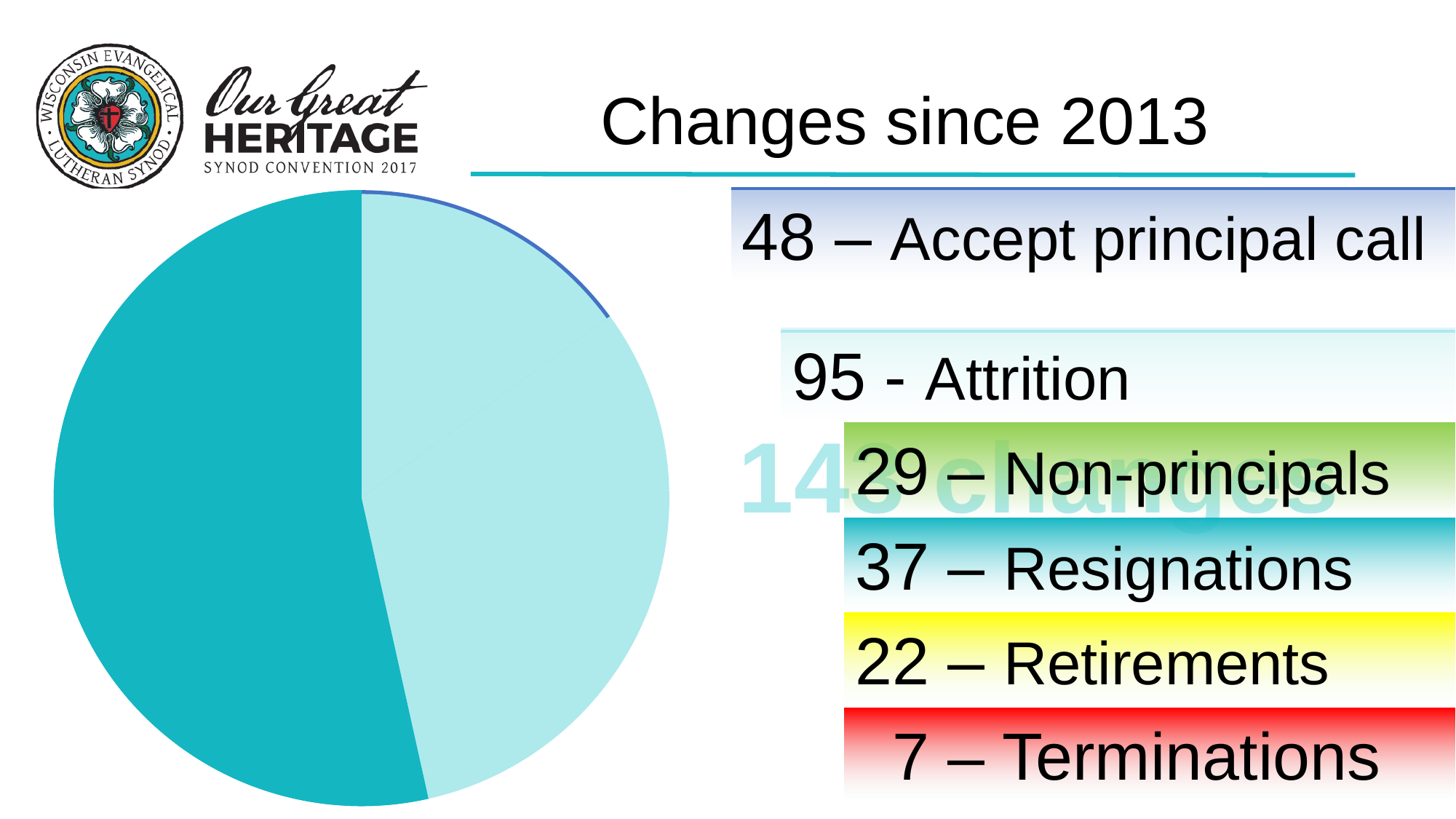
What is the title shown at the top of the slide above the chart? Changes since 2013 Does the light teal slice of the pie chart take up more or less than half of the pie? less Which slice of the pie chart is larger, the dark teal slice or the light teal slice? the dark teal slice What kind of chart is shown on the left of the slide? pie chart How many slices does the pie chart have? 2 What two colours are used for the slices of the pie chart? dark teal and light teal Does the dark teal slice of the pie chart take up more or less than half of the pie? more